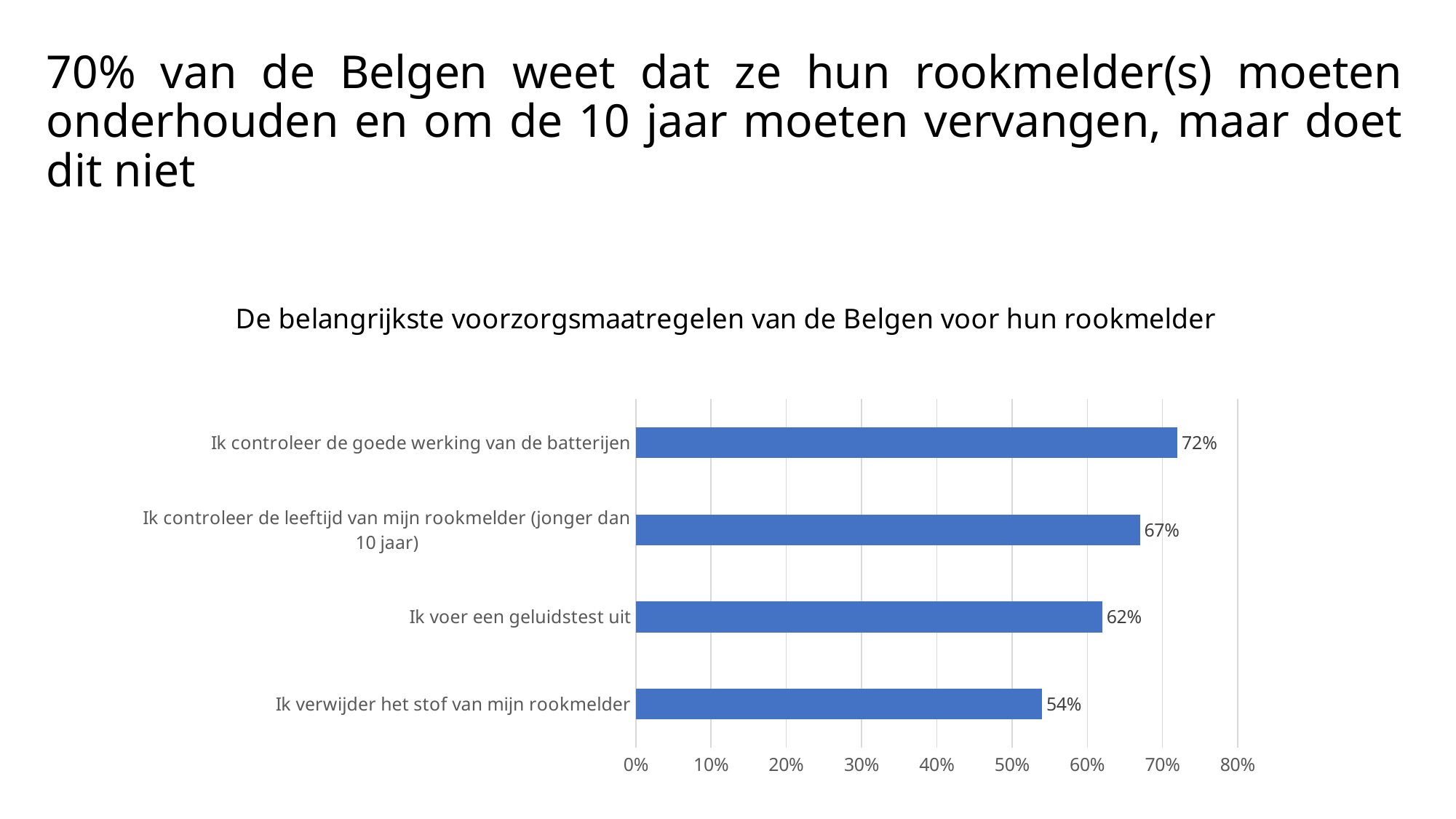
Is the value for 'Ik voer een geluidstest uit' greater or less than 60%? greater What is the title of the chart? De belangrijkste voorzorgsmaatregelen van de Belgen voor hun rookmelder What is the value for 'Ik controleer de goede werking van de batterijen'? 72% What kind of chart is shown on the slide? Bar chart What is the difference between the values for 'Ik controleer de goede werking van de batterijen' and 'Ik verwijder het stof van mijn rookmelder'? 18% Which category has the lowest value? Ik verwijder het stof van mijn rookmelder What is the value for 'Ik verwijder het stof van mijn rookmelder'? 54% Which category has the highest value? Ik controleer de goede werking van de batterijen How many categories are shown in the chart? 4 What is the value for 'Ik controleer de leeftijd van mijn rookmelder (jonger dan 10 jaar)'? 67% What is the value for 'Ik voer een geluidstest uit'? 62% Which is larger: the value for 'Ik voer een geluidstest uit' or for 'Ik controleer de leeftijd van mijn rookmelder (jonger dan 10 jaar)'? Ik controleer de leeftijd van mijn rookmelder (jonger dan 10 jaar)